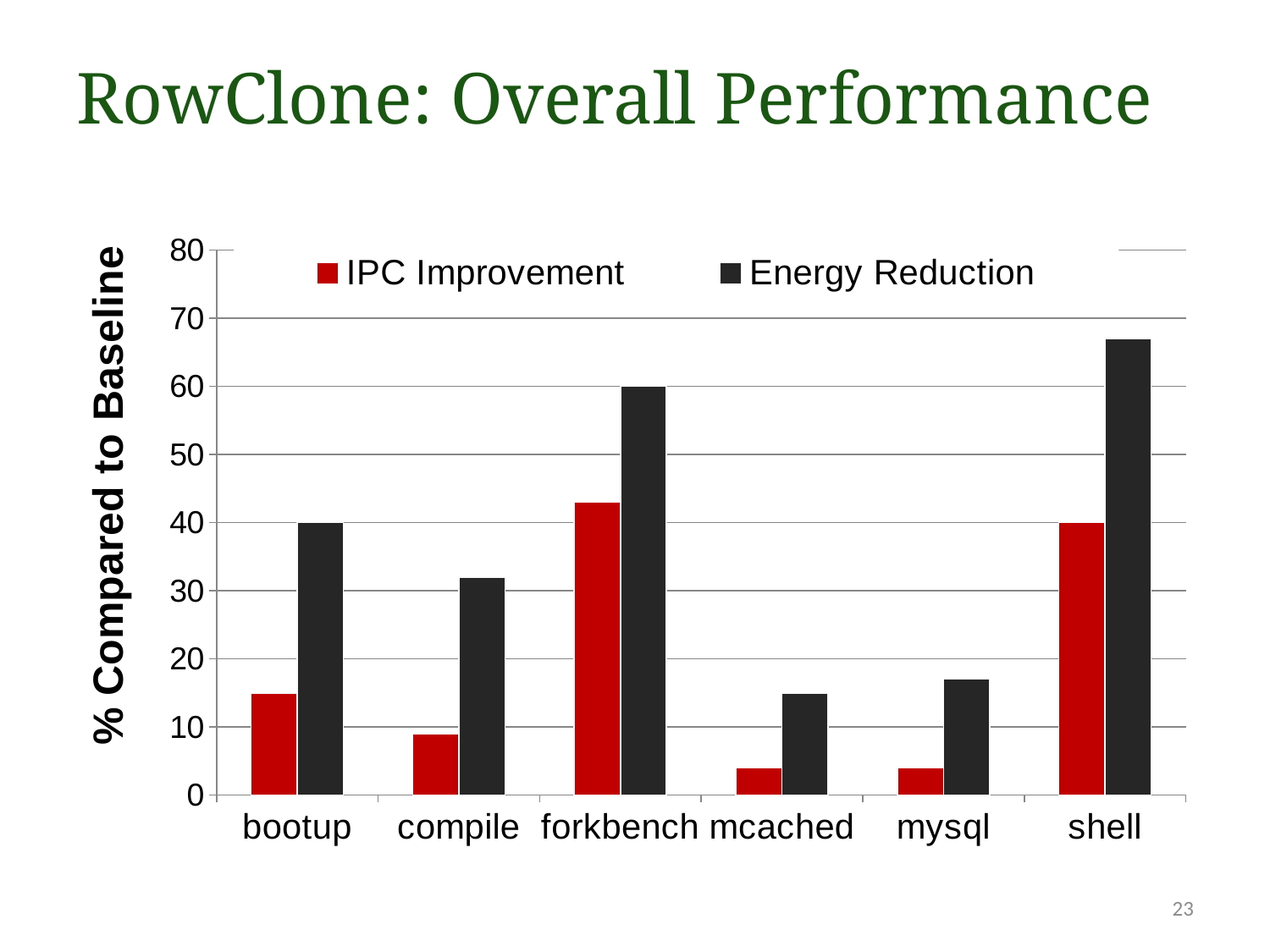
Is the IPC Improvement for mcached greater or less than 10? less How many series does the legend list? 2 Which is larger, the IPC Improvement for shell or the IPC Improvement for bootup? shell Is the Energy Reduction for shell greater or less than 60? greater Which is larger, the Energy Reduction for bootup or the Energy Reduction for compile? bootup What is the label of the y axis? % Compared to Baseline Which benchmark has the highest Energy Reduction? shell What kind of chart is shown on the slide? bar chart How many benchmark categories are shown on the x axis? 6 Which benchmark has the highest IPC Improvement? forkbench Is the IPC Improvement for compile greater or less than 10? less